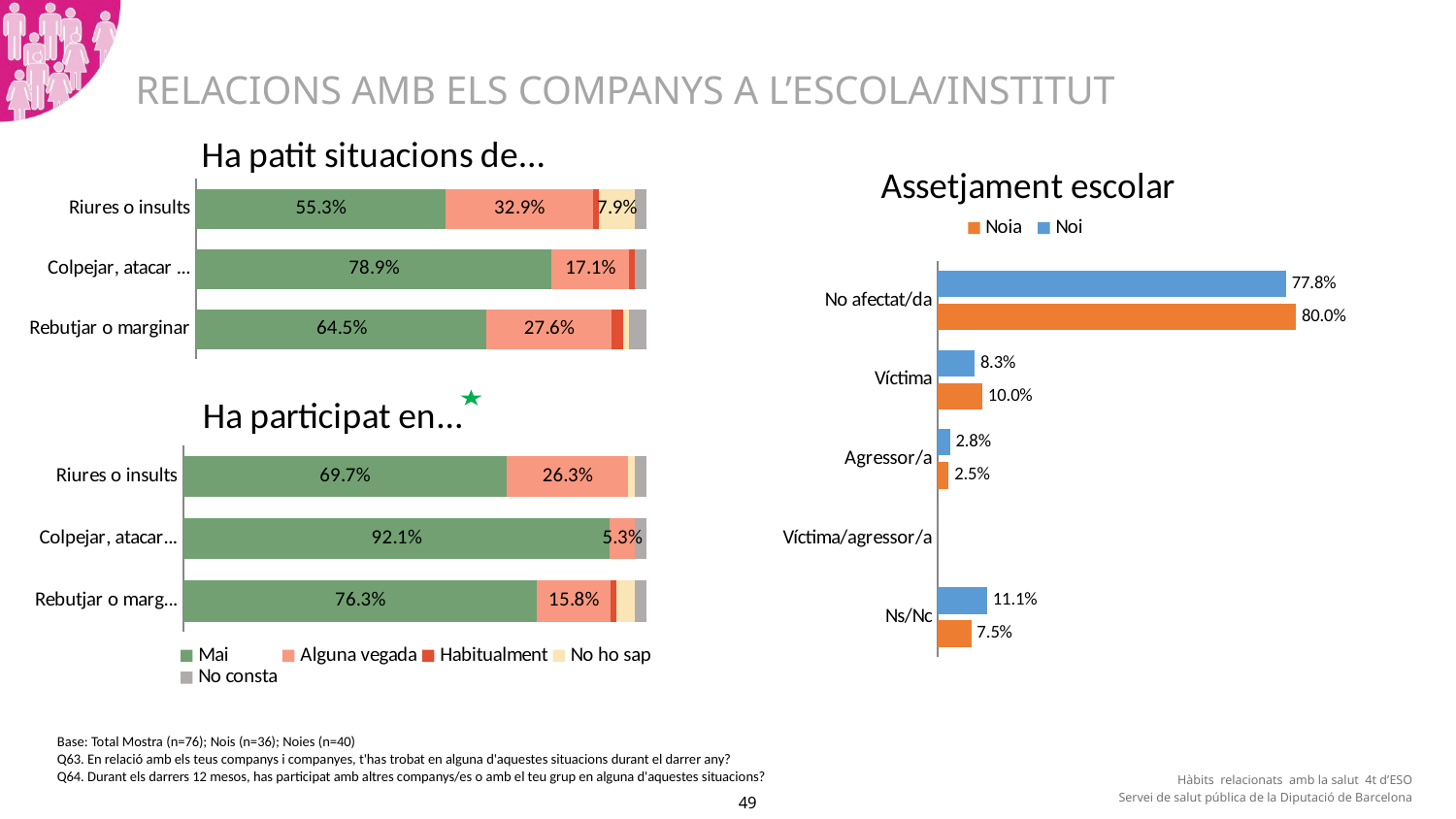
In the chart 'Assetjament escolar', which is larger for 'Agressor/a', the 'Noi' value or the 'Noia' value? Noi In the chart 'Ha participat en...', what is the 'Alguna vegada' value for 'Riures o insults'? 26.3% In the chart 'Assetjament escolar', what is the difference between the 'Noia' and 'Noi' values for 'Víctima'? 1.7% In the chart 'Ha patit situacions de...', what is the difference between the 'Mai' values for 'Colpejar, atacar' and 'Rebutjar o marginar'? 14.4% In the chart 'Assetjament escolar', what is the 'Noia' value for 'No afectat/da'? 80.0% How many series does the legend below the chart 'Ha participat en...' list? 5 What kind of chart is 'Assetjament escolar'? Bar chart In the chart 'Assetjament escolar', what is the 'Noi' value for 'Ns/Nc'? 11.1% In the chart 'Ha participat en...', which category has the highest 'Mai' value? Colpejar, atacar How many categories are shown in the chart 'Assetjament escolar'? 5 In the chart 'Ha patit situacions de...', which category has the lowest 'Mai' value? Riures o insults In the chart 'Ha patit situacions de...', what is the 'Mai' value for 'Colpejar, atacar'? 78.9%